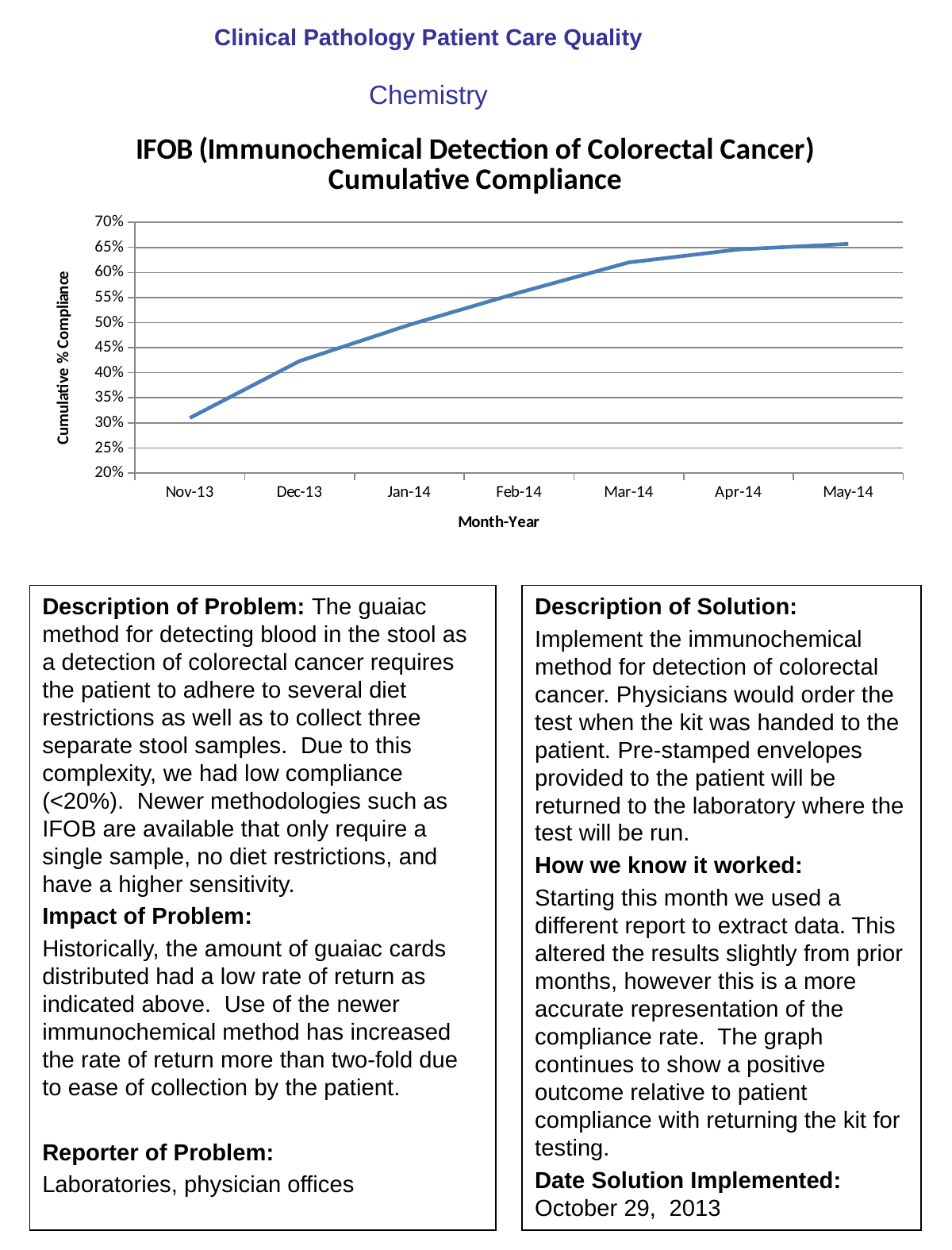
How many months are plotted on the x axis of the chart? 7 What is the label on the y axis of the chart? Cumulative % Compliance Is the value for Dec-13 greater or less than 40%? greater Which is larger, the value for Dec-13 or the value for Mar-14? Mar-14 What is the label on the x axis of the chart? Month-Year Is the value for May-14 greater or less than 70%? less Which month has the lowest cumulative % compliance? Nov-13 Is the value for Nov-13 greater or less than 35%? less What kind of chart is shown on the slide? line chart Which month has the highest cumulative % compliance? May-14 Do the cumulative compliance values rise or fall from Nov-13 to May-14? rise